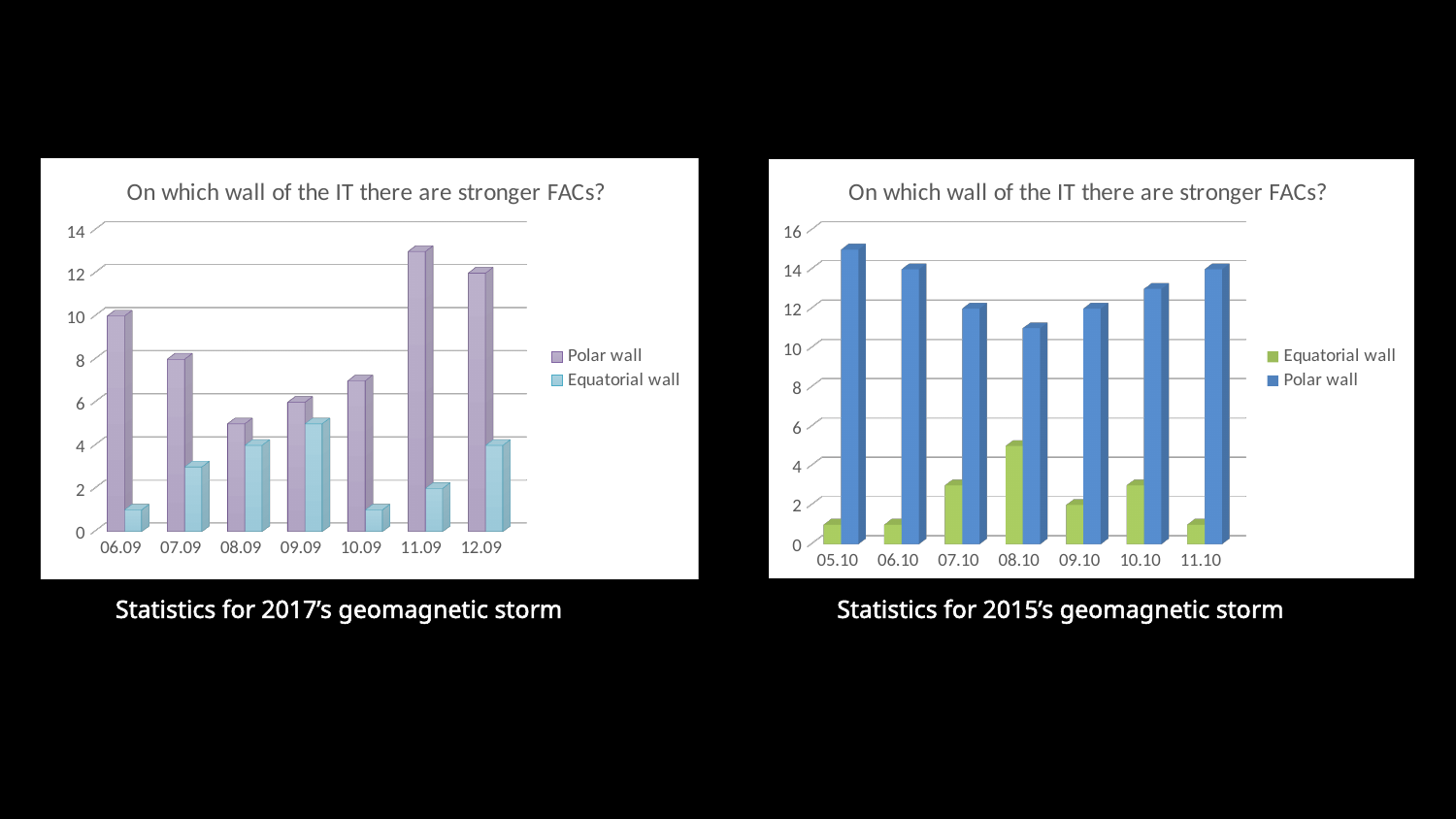
In the right chart (Statistics for 2015's geomagnetic storm), on which date is the Polar wall value lowest? 08.10 In the left chart (Statistics for 2017's geomagnetic storm), on which date is the Polar wall value highest? 11.09 In the right chart (Statistics for 2015's geomagnetic storm), on which date is the Polar wall value highest? 05.10 In the left chart (Statistics for 2017's geomagnetic storm), is the Polar wall value for 06.09 greater or less than 8? greater In the right chart (Statistics for 2015's geomagnetic storm), is the Polar wall value for 11.10 greater or less than 12? greater In the left chart (Statistics for 2017's geomagnetic storm), which date has the larger Polar wall value, 06.09 or 07.09? 06.09 How many dates are shown on the x axis of the left chart (Statistics for 2017's geomagnetic storm)? 7 In the right chart (Statistics for 2015's geomagnetic storm), which date has the larger Polar wall value, 05.10 or 08.10? 05.10 In the right chart (Statistics for 2015's geomagnetic storm), is the Equatorial wall value for 08.10 greater or less than 4? greater What kind of chart is the left chart (Statistics for 2017's geomagnetic storm)? bar chart How many series does the legend of the right chart (Statistics for 2015's geomagnetic storm) list? 2 What are the two legend entries of the right chart (Statistics for 2015's geomagnetic storm)? Equatorial wall, Polar wall